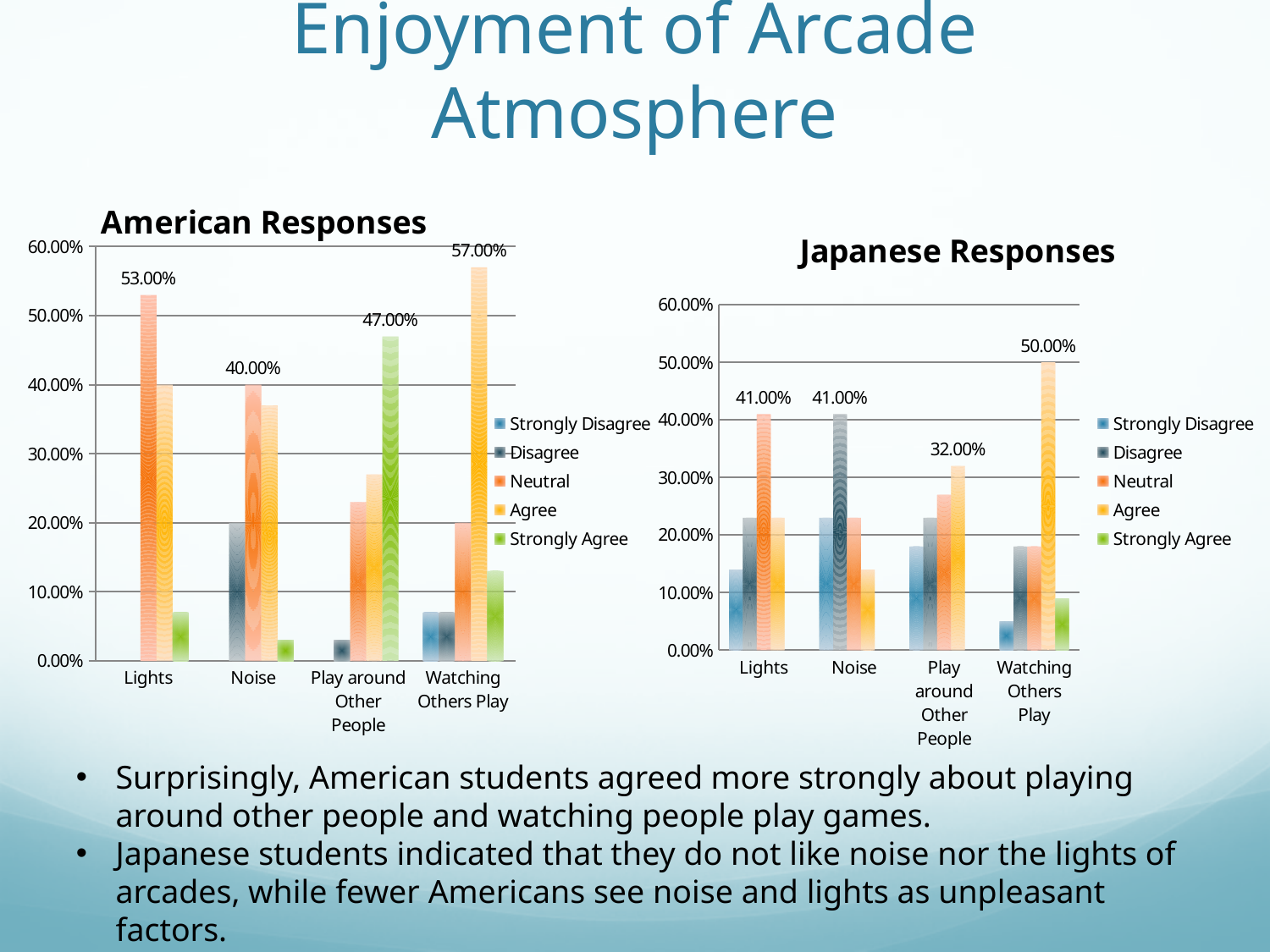
In the American Responses chart, is the Strongly Agree value for Noise greater or less than 10.00%? less In the Japanese Responses chart, what is the Agree value for Watching Others Play? 50.00% In the American Responses chart, what is the Agree value for Watching Others Play? 57.00% In the American Responses chart, what is the difference between the Agree value for Watching Others Play and the Neutral value for Lights? 4.00% In the Japanese Responses chart, what is the Agree value for Play around Other People? 32.00% What kind of chart is the Japanese Responses chart? Bar chart How many series does the legend of the Japanese Responses chart list? 5 In the Japanese Responses chart, what is the Disagree value for Noise? 41.00% How many categories are shown on the x axis of the American Responses chart? 4 In the American Responses chart, what is the Neutral value for Lights? 53.00% In the American Responses chart, what is the Strongly Agree value for Play around Other People? 47.00% In the Japanese Responses chart, what is the difference between the Agree value for Watching Others Play and the Agree value for Play around Other People? 18.00%